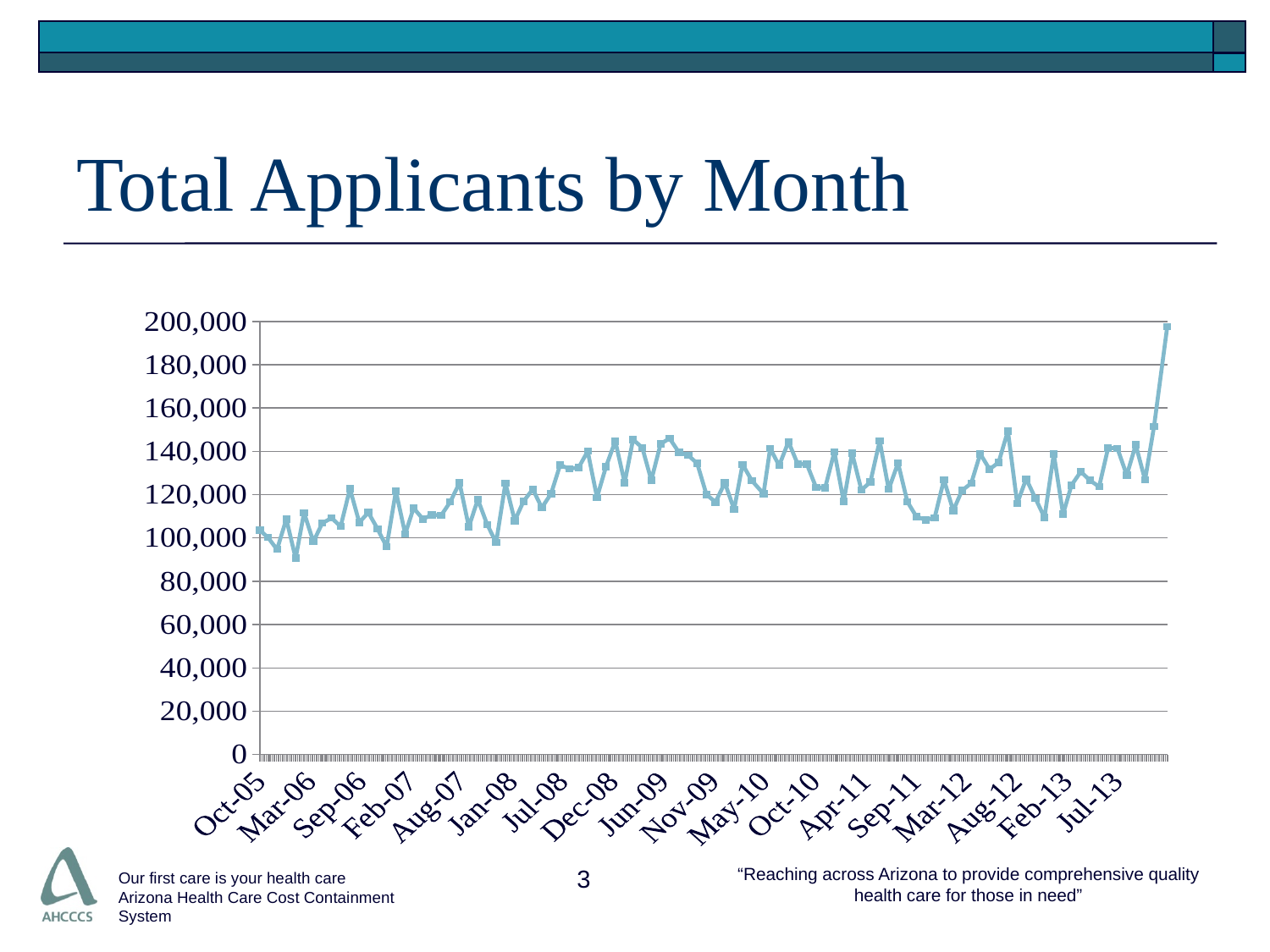
Is the value for Jul-13 greater or less than 100,000? greater Is the value for Oct-05 larger or smaller than the value at the end of the series? smaller What kind of chart is shown on the slide? line chart What is the title of the chart? Total Applicants by Month Does the final point of the series lie above or below 180,000? above How many month labels are printed along the x axis? 18 What is the highest value shown on the y axis? 200,000 Is the value for Jun-09 greater or less than 120,000? greater What is the first month label on the x axis? Oct-05 Overall, do the values rise or fall from the start of the series to the end? rise